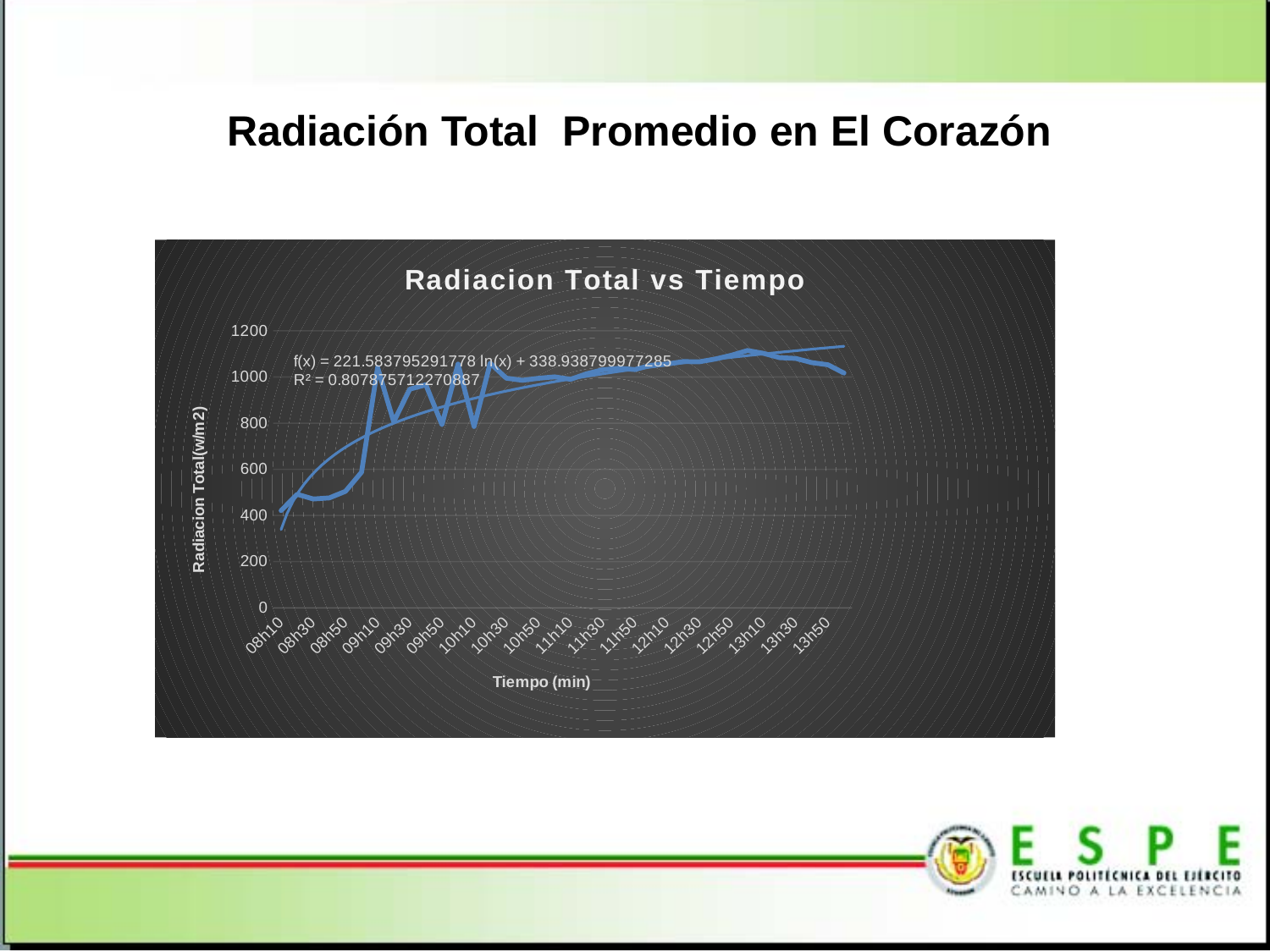
Is the radiation value at 12h50 greater or less than 1000? greater At which time label is the radiation value lowest? 08h10 Overall, does the radiation value rise or fall from 08h10 to 13h50? rise What kind of chart is shown on the slide? line chart Is the radiation value at 11h30 greater or less than 600? greater Which has the higher radiation value, 08h10 or 13h50? 13h50 What is the highest value shown on the y axis? 1200 What is the title of the chart? Radiacion Total vs Tiempo What R² value is printed on the chart for the trendline? R² = 0.807875712270887 Is the radiation value at 08h10 greater or less than 600? less Which has the higher radiation value, 08h50 or 11h50? 11h50